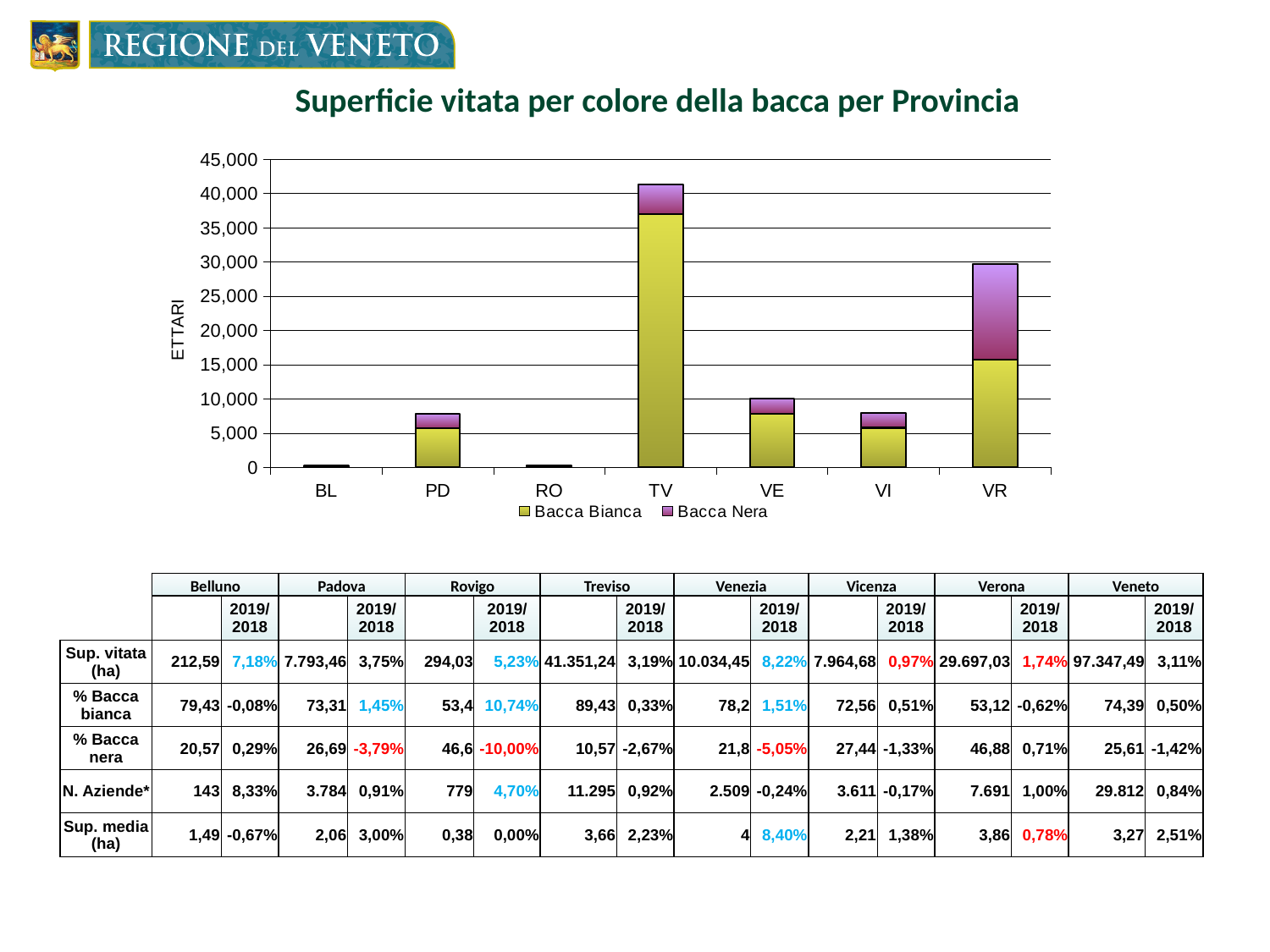
Is the total bar for VR greater or less than 25,000? greater How many series does the chart legend list? 2 How many provinces are shown on the x axis of the chart? 7 What are the two series named in the chart legend? Bacca Bianca and Bacca Nera Which province has the tallest bar in the chart? TV Is the total bar for TV greater or less than 35,000? greater Is the total bar for BL greater or less than 5,000? less Which bar is taller, VR or VE? VR Which bar is taller, TV or VR? TV What is the label on the y axis of the chart? ETTARI What kind of chart is shown on the slide? Stacked bar chart